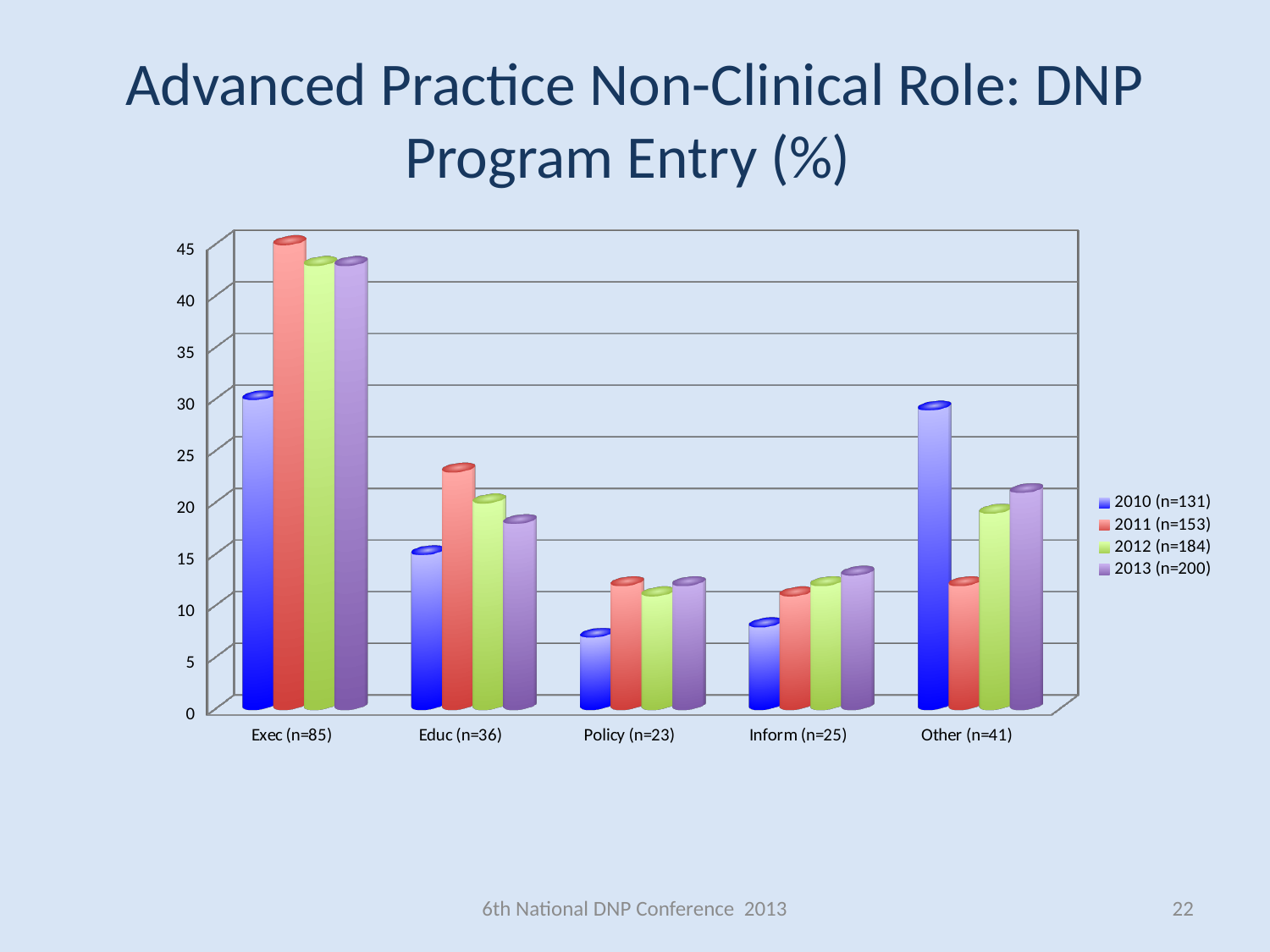
Which is larger in the Educ (n=36) category: the value for 2011 (n=153) or for 2013 (n=200)? 2011 (n=153) How many series does the chart's legend list? 4 Is the value for 2010 (n=131) in the Other (n=41) category greater or less than 25? greater Which series has the highest value in the Other (n=41) category? 2010 (n=131) Is the value for 2011 (n=153) in the Exec (n=85) category greater or less than 40? greater Is the value for 2010 (n=131) in the Policy (n=23) category greater or less than 10? less What kind of chart is shown on the slide? bar chart Which is larger in the Exec (n=85) category: the value for 2010 (n=131) or for 2011 (n=153)? 2011 (n=153) Which category has the highest value for the 2011 (n=153) series? Exec (n=85) What is the title of the chart on the slide? Advanced Practice Non-Clinical Role: DNP Program Entry (%) Which series has the lowest value in the Educ (n=36) category? 2010 (n=131) How many categories are shown on the x axis of the chart? 5